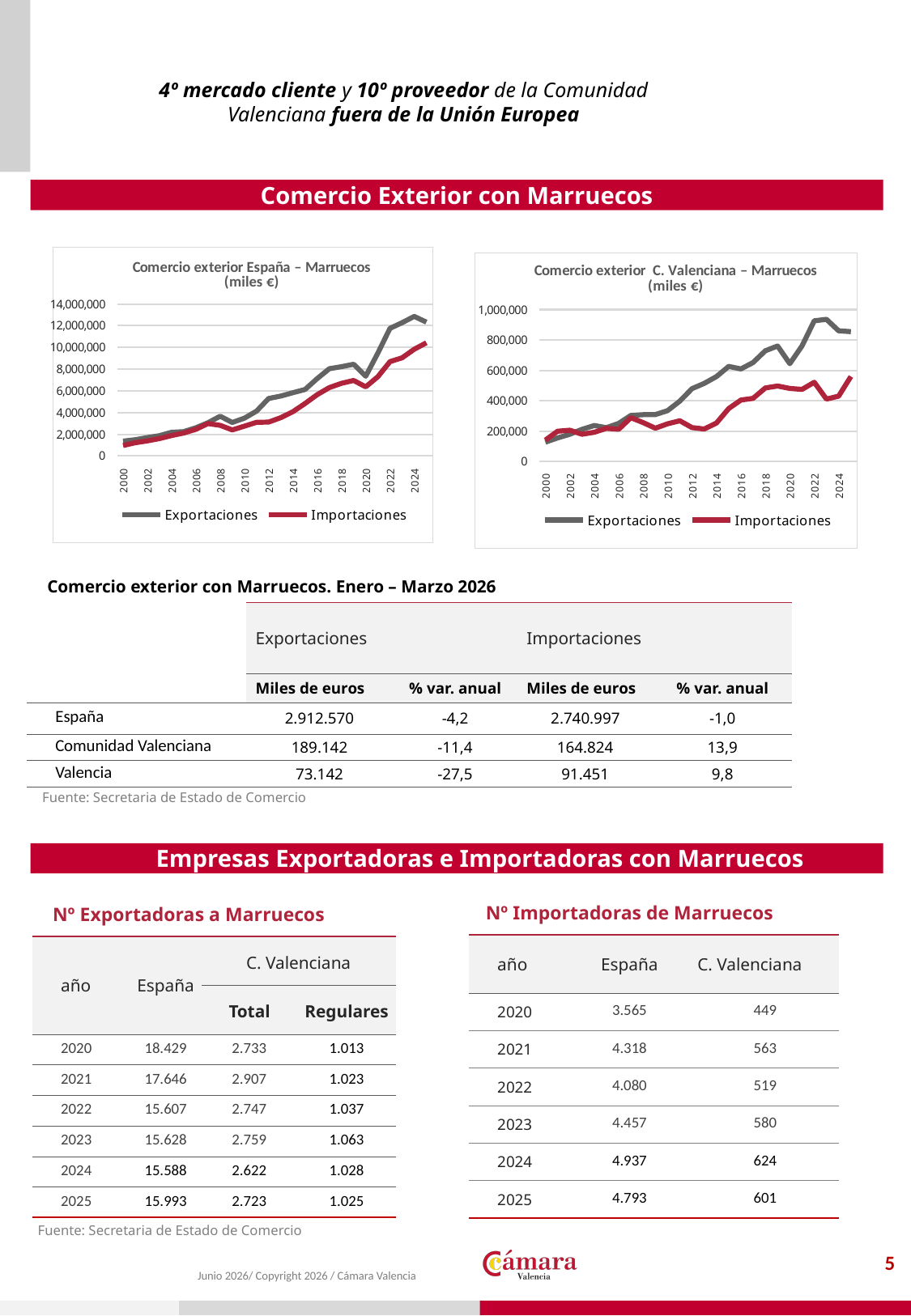
In the 'Comercio exterior C. Valenciana – Marruecos' chart, is the value of Exportaciones in 2022 greater or less than 800,000? greater In the 'Comercio exterior C. Valenciana – Marruecos' chart, which series is higher in 2024, Exportaciones or Importaciones? Exportaciones In the 'Comercio exterior España – Marruecos' chart, what unit is given in the title? miles € In the 'Comercio exterior España – Marruecos' chart, is the value of Importaciones in 2024 greater or less than 8,000,000? greater In the 'Comercio exterior España – Marruecos' chart, is the value of Exportaciones in 2024 greater or less than 10,000,000? greater In the 'Comercio exterior España – Marruecos' chart, do Exportaciones generally rise or fall from 2000 to 2024? rise What are the two series named in the legend of the 'Comercio exterior España – Marruecos' chart? Exportaciones and Importaciones In the 'Comercio exterior España – Marruecos' chart, which series is higher in 2024, Exportaciones or Importaciones? Exportaciones What kind of chart is the 'Comercio exterior España – Marruecos' chart? line chart How many series does the legend of the 'Comercio exterior C. Valenciana – Marruecos' chart list? 2